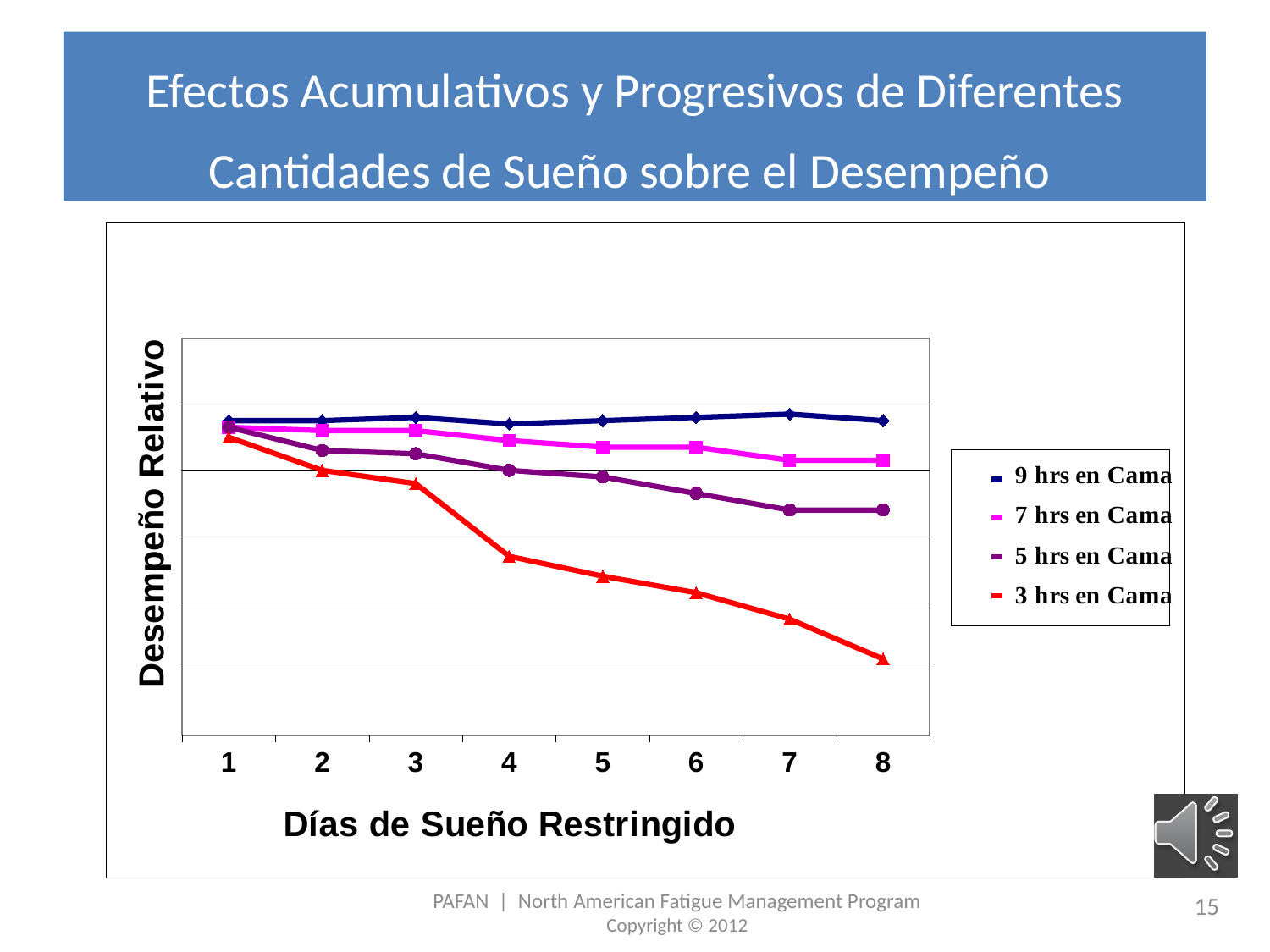
Which series stays roughly flat across the 8 days? 9 hrs en Cama How many days are shown along the x axis? 8 What is the title of the y axis? Desempeño Relativo On day 4, which is higher: the '5 hrs en Cama' series or the '3 hrs en Cama' series? 5 hrs en Cama On day 8, which is higher: the '7 hrs en Cama' series or the '5 hrs en Cama' series? 7 hrs en Cama Does the value for the '3 hrs en Cama' series rise or fall as the days of restricted sleep increase? Fall Which series has the highest relative performance on day 8? 9 hrs en Cama What kind of chart is shown on the slide? Line chart Which series has the lowest relative performance on day 8? 3 hrs en Cama How many series does the legend list? 4 What is the title of the x axis? Días de Sueño Restringido